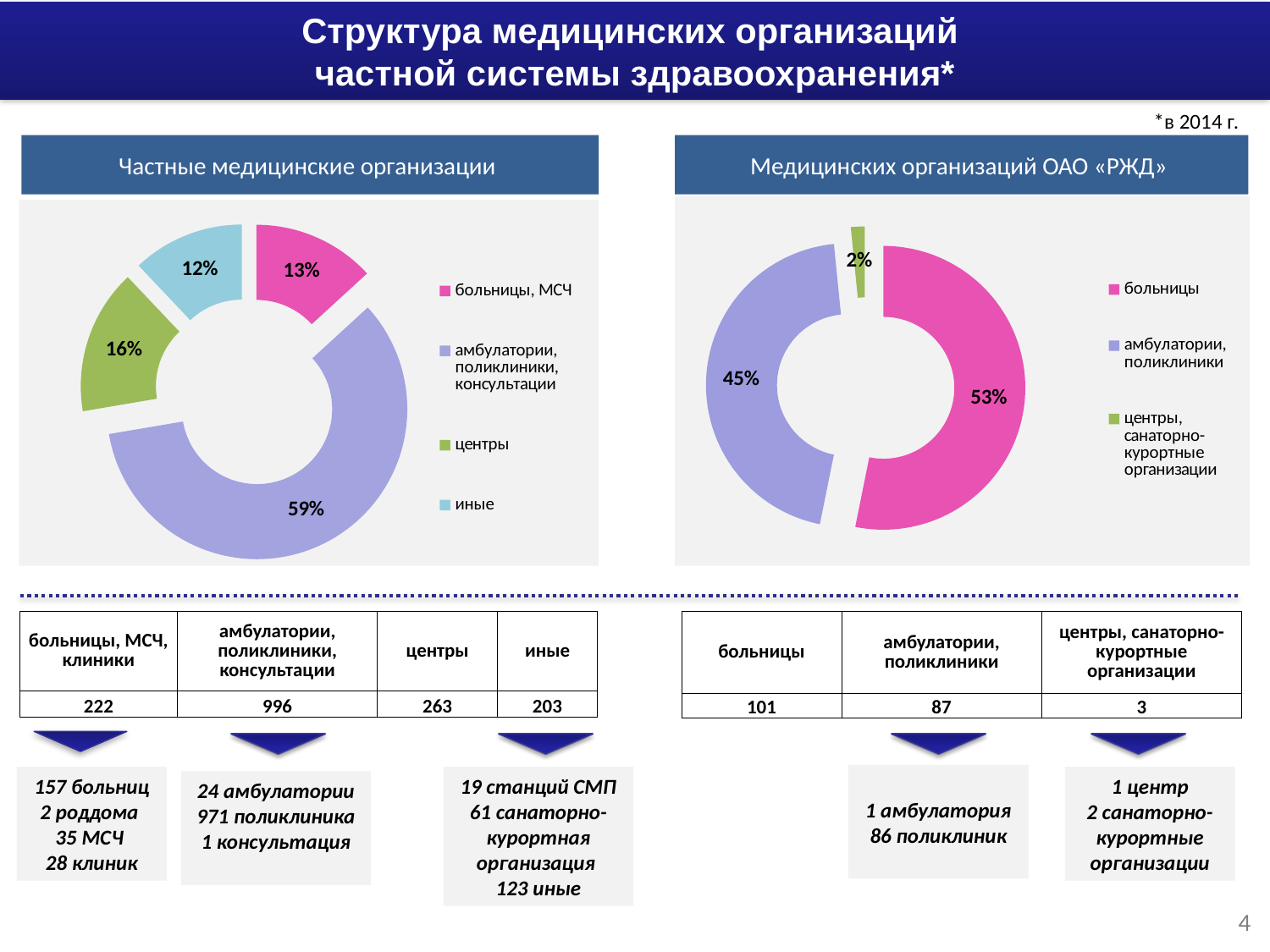
In the chart titled «Частные медицинские организации», what share is shown for «амбулатории, поликлиники, консультации»? 59% In the chart titled «Частные медицинские организации», what share is shown for «центры»? 16% In the chart titled «Частные медицинские организации», how many categories does the legend list? 4 In the chart titled «Медицинских организаций ОАО «РЖД»», what share is shown for «больницы»? 53% In the chart titled «Медицинских организаций ОАО «РЖД»», what share is shown for «центры, санаторно-курортные организации»? 2% What type of chart is used on the slide for «Медицинских организаций ОАО «РЖД»»? pie (donut) chart In the chart titled «Частные медицинские организации», what share is shown for «иные»? 12% In the chart titled «Частные медицинские организации», what is the difference in percentage points between «центры» and «больницы, МСЧ»? 3 In the chart titled «Частные медицинские организации», which category has the smallest share? иные In the chart titled «Медицинских организаций ОАО «РЖД»», what is the difference in percentage points between «больницы» and «амбулатории, поликлиники»? 8 In the chart titled «Медицинских организаций ОАО «РЖД»», which is larger: «больницы» or «амбулатории, поликлиники»? больницы In the chart titled «Частные медицинские организации», which category has the largest share? амбулатории, поликлиники, консультации